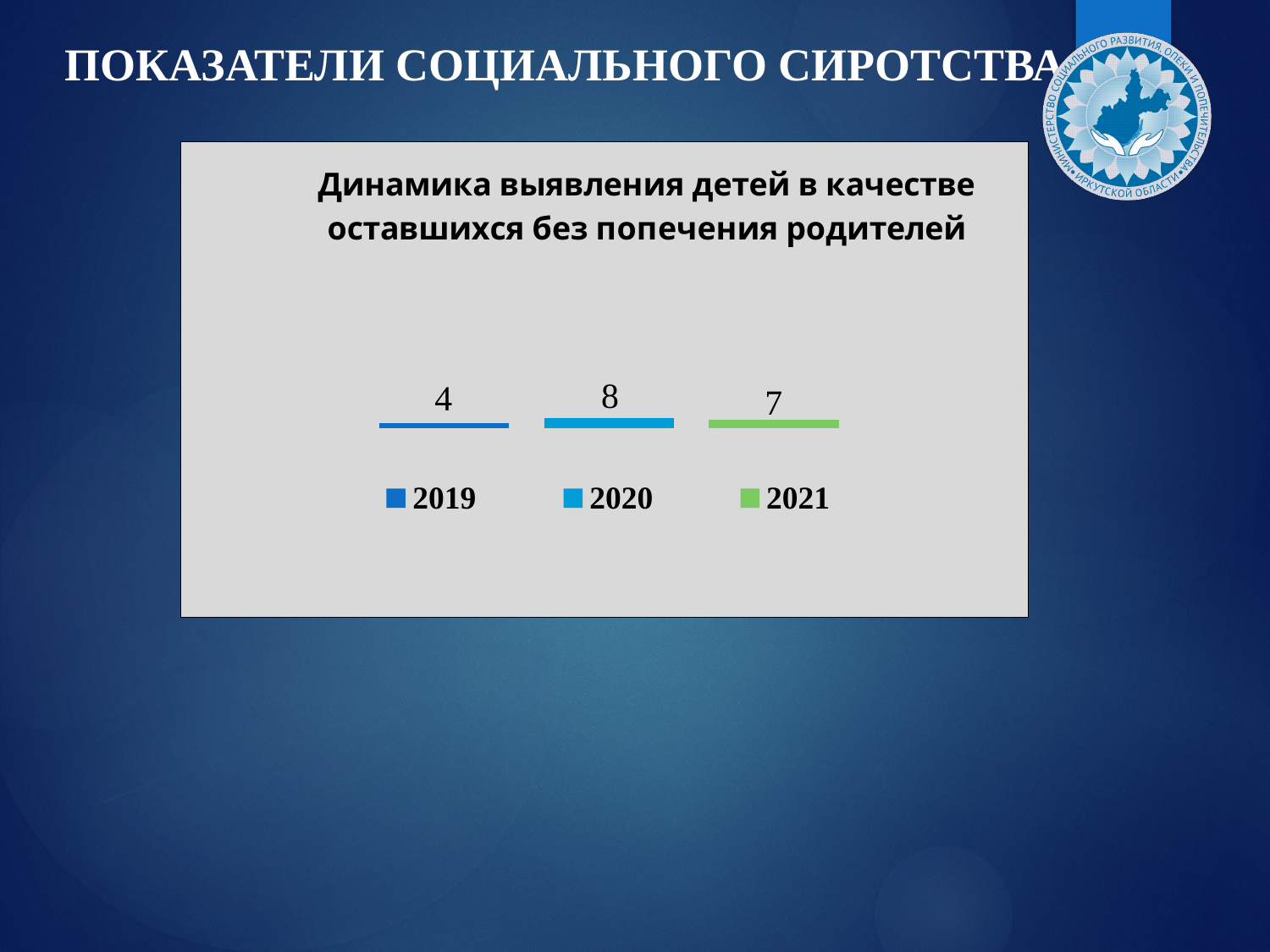
Which is larger, the value for 2021 or the value for 2019? 2021 What is the value for 2019 in the chart? 4 What is the difference between the values for 2020 and 2019? 4 What kind of chart is shown on the slide? bar chart Which year has the lowest value in the chart? 2019 What is the title of the chart? Динамика выявления детей в качестве оставшихся без попечения родителей What is the difference between the values for 2020 and 2021? 1 What is the value for 2020 in the chart? 8 What colour is the bar for 2021 in the chart? green Which year has the highest value in the chart? 2020 What is the value for 2021 in the chart? 7 How many series does the legend list? 3